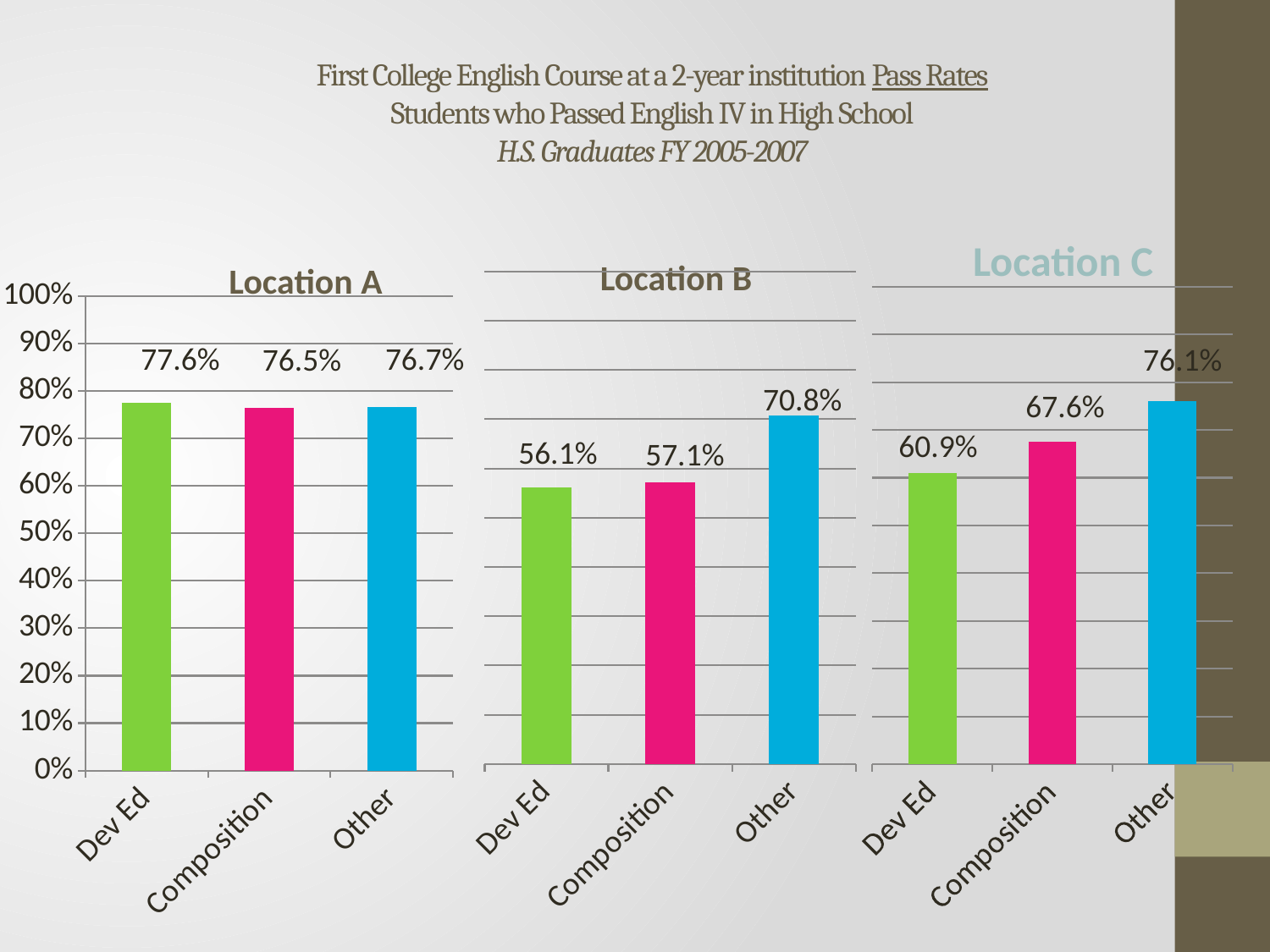
In the Location B chart, which category has the highest pass rate? Other In the Location B chart, is the value for Dev Ed greater or less than 60%? less In the Location C chart, do the values rise or fall from Dev Ed to Other? rise Which is larger: the Dev Ed pass rate in the Location A chart or the Dev Ed pass rate in the Location B chart? Location A In the Location A chart, what is the pass rate for Dev Ed? 77.6% In the Location C chart, what is the difference between the pass rates for Composition and Dev Ed? 6.7% What kind of chart is the Location C chart? bar chart In the Location C chart, which category has the lowest pass rate? Dev Ed In the Location C chart, what is the pass rate for Other? 76.1% In the Location B chart, what is the difference between the pass rates for Other and Dev Ed? 14.7% How many categories are shown in the Location A chart? 3 In the Location B chart, what is the pass rate for Composition? 57.1%